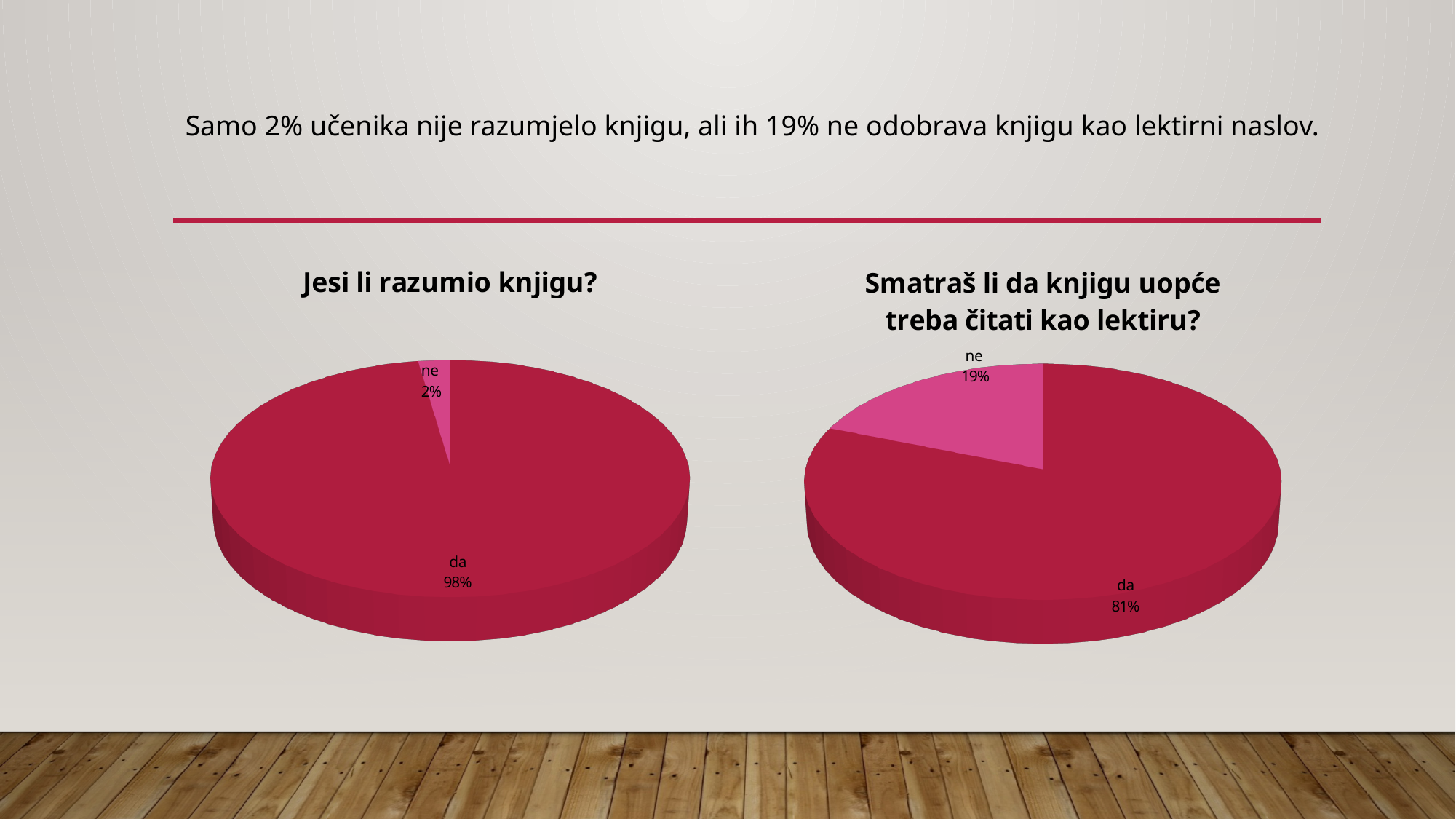
In the chart titled "Smatraš li da knjigu uopće treba čitati kao lektiru?", what share of the pie is labelled "da"? 81% In the chart titled "Jesi li razumio knjigu?", what share of the pie is labelled "da"? 98% In the chart on the left, which slice is the largest? da In the chart on the right, what is the difference between the "da" and "ne" shares? 62% In the chart on the right, which slice is the smallest? ne Which is larger: the "ne" share in the left chart or the "ne" share in the right chart? the right chart What is the title of the chart on the left? Jesi li razumio knjigu? What kind of chart is the chart on the right? pie chart In the chart titled "Jesi li razumio knjigu?", what share of the pie is labelled "ne"? 2% In the chart on the left, what is the difference between the "da" and "ne" shares? 96% How many slices does the chart titled "Jesi li razumio knjigu?" have? 2